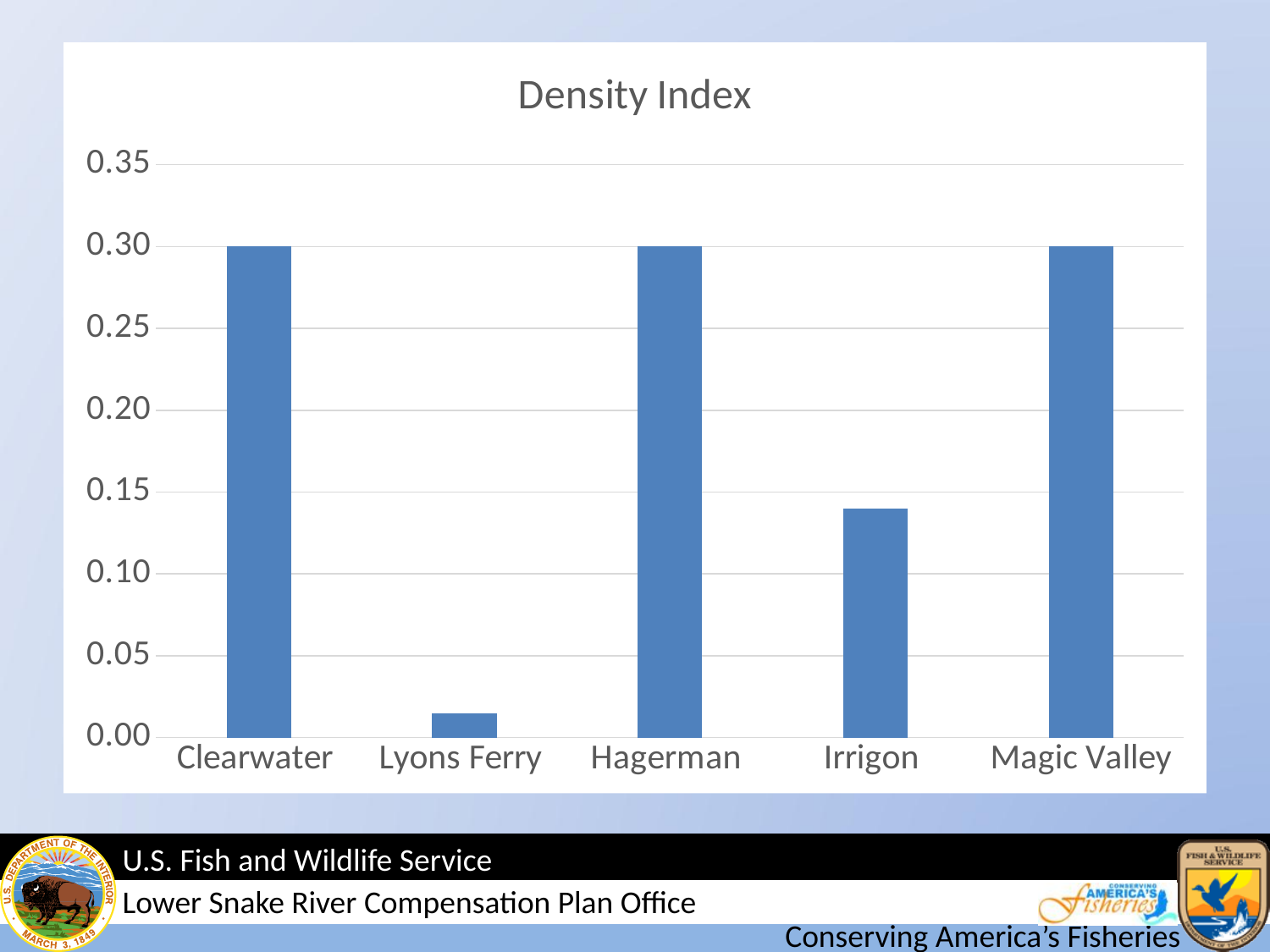
What is the Density Index value for Clearwater? 0.30 How many categories are plotted on the x axis? 5 Is the value for Lyons Ferry greater or less than 0.05? less What is the title of the chart? Density Index Is the value for Irrigon greater or less than 0.15? less Which category has the lowest Density Index? Lyons Ferry What is the Density Index value for Magic Valley? 0.30 Which has a higher Density Index, Clearwater or Irrigon? Clearwater Is the value for Irrigon greater or less than 0.10? greater What kind of chart is shown on the slide? bar chart What is the Density Index value for Hagerman? 0.30 Which has a higher Density Index, Irrigon or Lyons Ferry? Irrigon